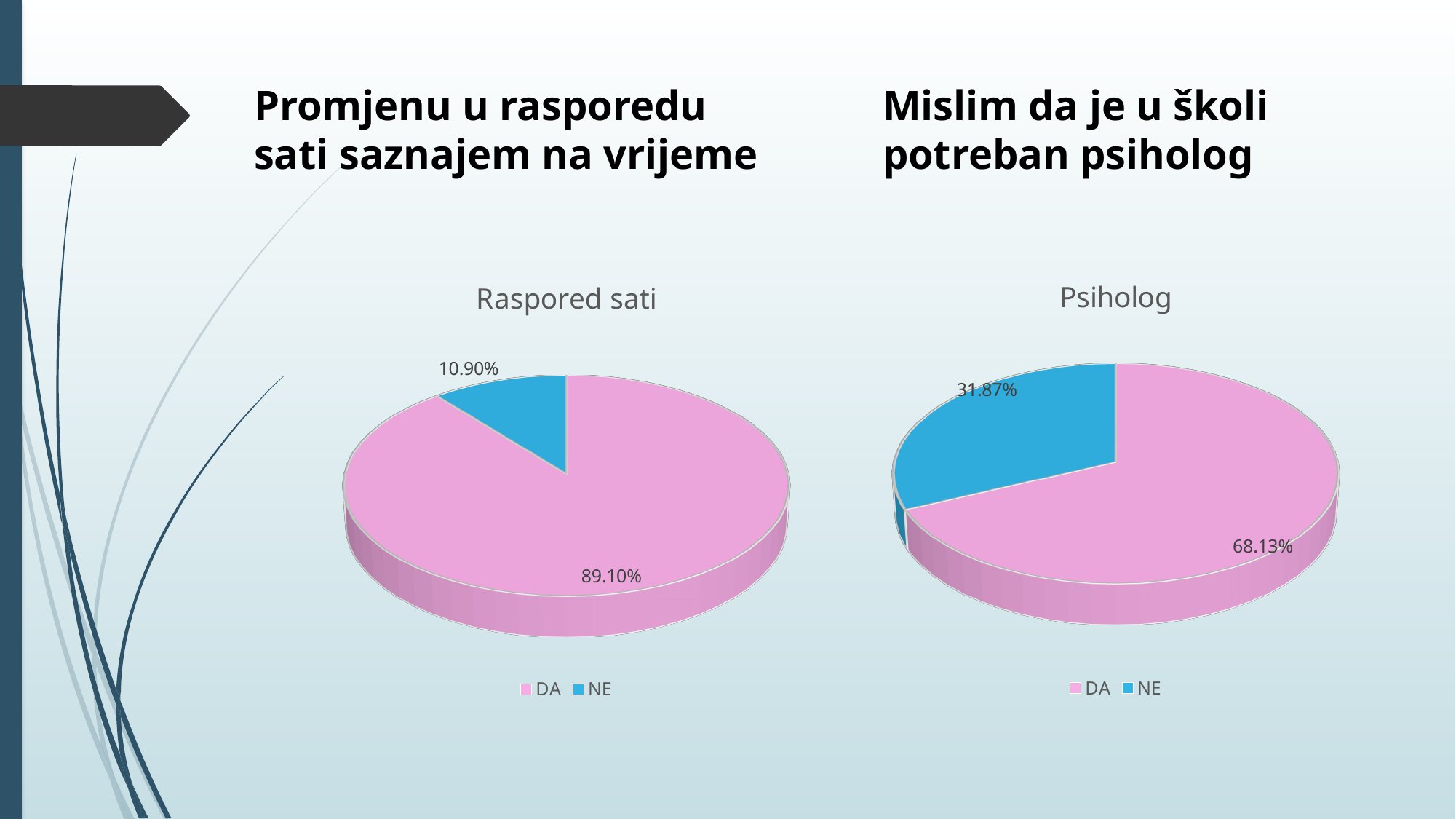
In the 'Raspored sati' chart, which slice is the largest? DA In the 'Psiholog' chart, what percentage is shown for NE? 31.87% In the 'Psiholog' chart, what is the difference between the DA and NE percentages? 36.26% In the 'Psiholog' chart, what percentage is shown for DA? 68.13% In the 'Raspored sati' chart, what percentage is shown for NE? 10.90% How many slices does the 'Psiholog' pie chart have? 2 Is the NE share larger in the 'Raspored sati' chart or in the 'Psiholog' chart? Psiholog In the 'Psiholog' chart, which slice is the smallest? NE What type of chart is the 'Raspored sati' chart? Pie chart In the 'Psiholog' chart, what colour represents NE? Blue How many entries does the legend of the 'Raspored sati' chart list? 2 In the 'Raspored sati' chart, what percentage is shown for DA? 89.10%